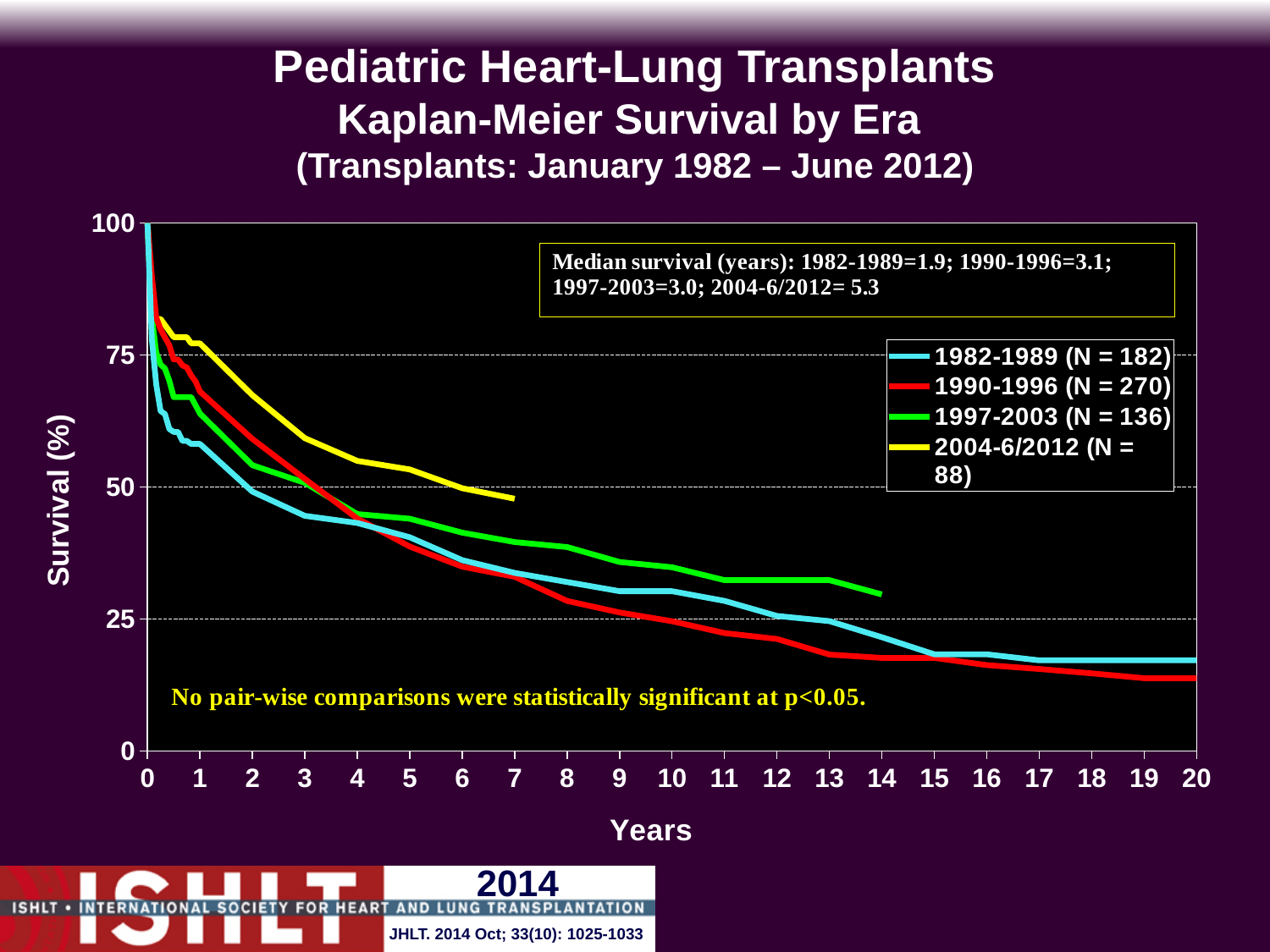
At 10 years, which era has higher survival: 1997-2003 or 1990-1996? 1997-2003 What is the number of patients (N) in the 1990-1996 era? 270 Which era has the lowest median survival? 1982-1989 Is the survival for the 1997-2003 era at 14 years greater or less than 25%? greater Do the survival curves rise or fall as years increase? Fall How many series (eras) does the legend list? 4 Which colour represents the 1982-1989 era in the chart? Blue What type of chart is shown on the slide? Line chart What is the median survival in years for the 1982-1989 era? 1.9 Which era has the highest median survival? 2004-6/2012 What is the median survival in years for the 2004-6/2012 era? 5.3 What is the difference in median survival (years) between the 2004-6/2012 era and the 1982-1989 era? 3.4